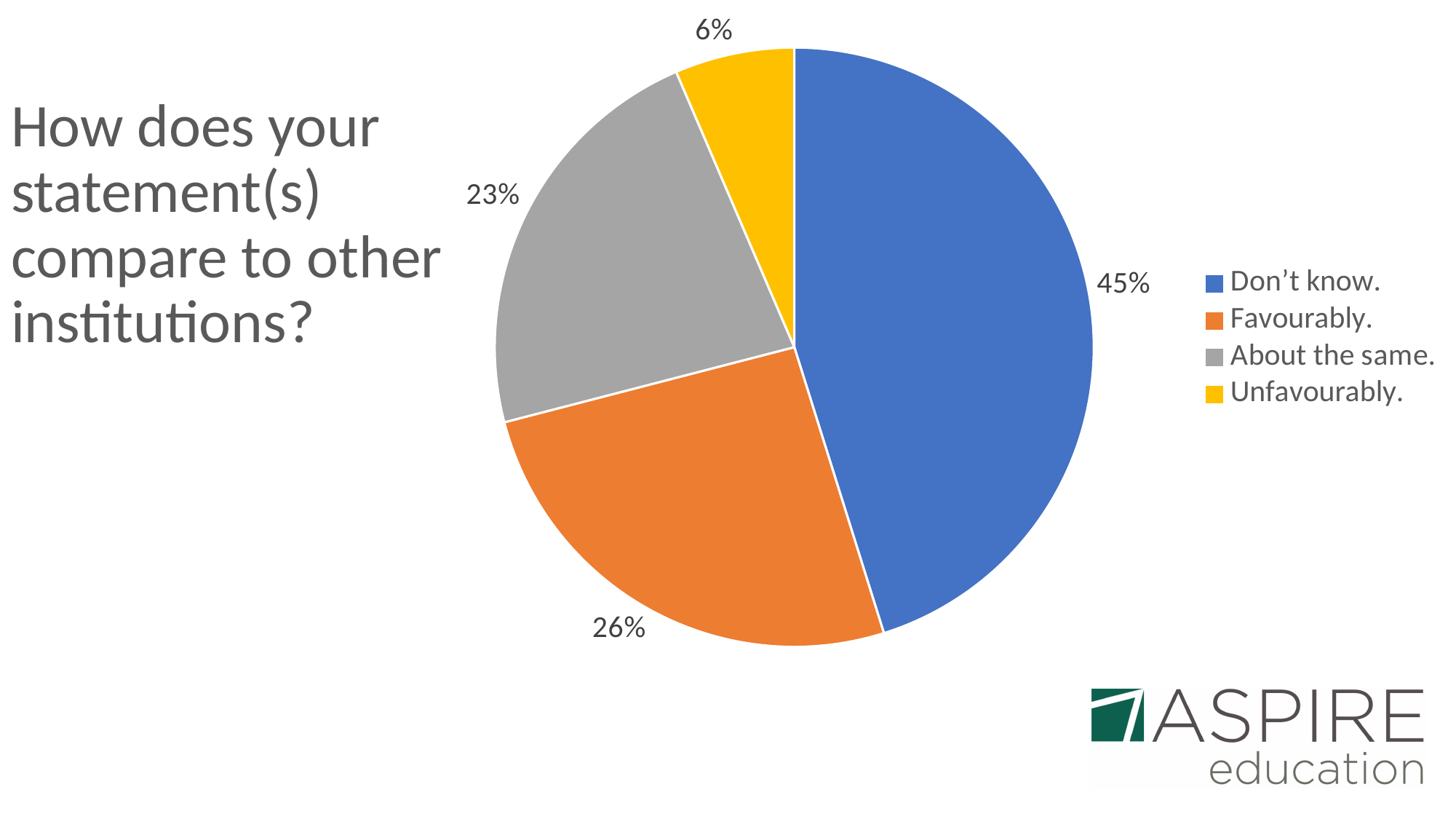
Which is larger, the share for "Don't know." or the share for "Favourably."? Don't know. Which category has the smallest slice of the pie? Unfavourably. What colour is the slice for "About the same."? grey Which category has the largest slice of the pie? Don't know. What kind of chart is shown on the slide? pie chart What share of the pie is labelled "Unfavourably."? 6% What share of the pie is labelled "Favourably."? 26% What is the difference in percentage points between "Don't know." and "Unfavourably."? 39% What share of the pie is labelled "Don't know."? 45% What is the difference in percentage points between "Favourably." and "About the same."? 3% How many categories does the pie chart show? 4